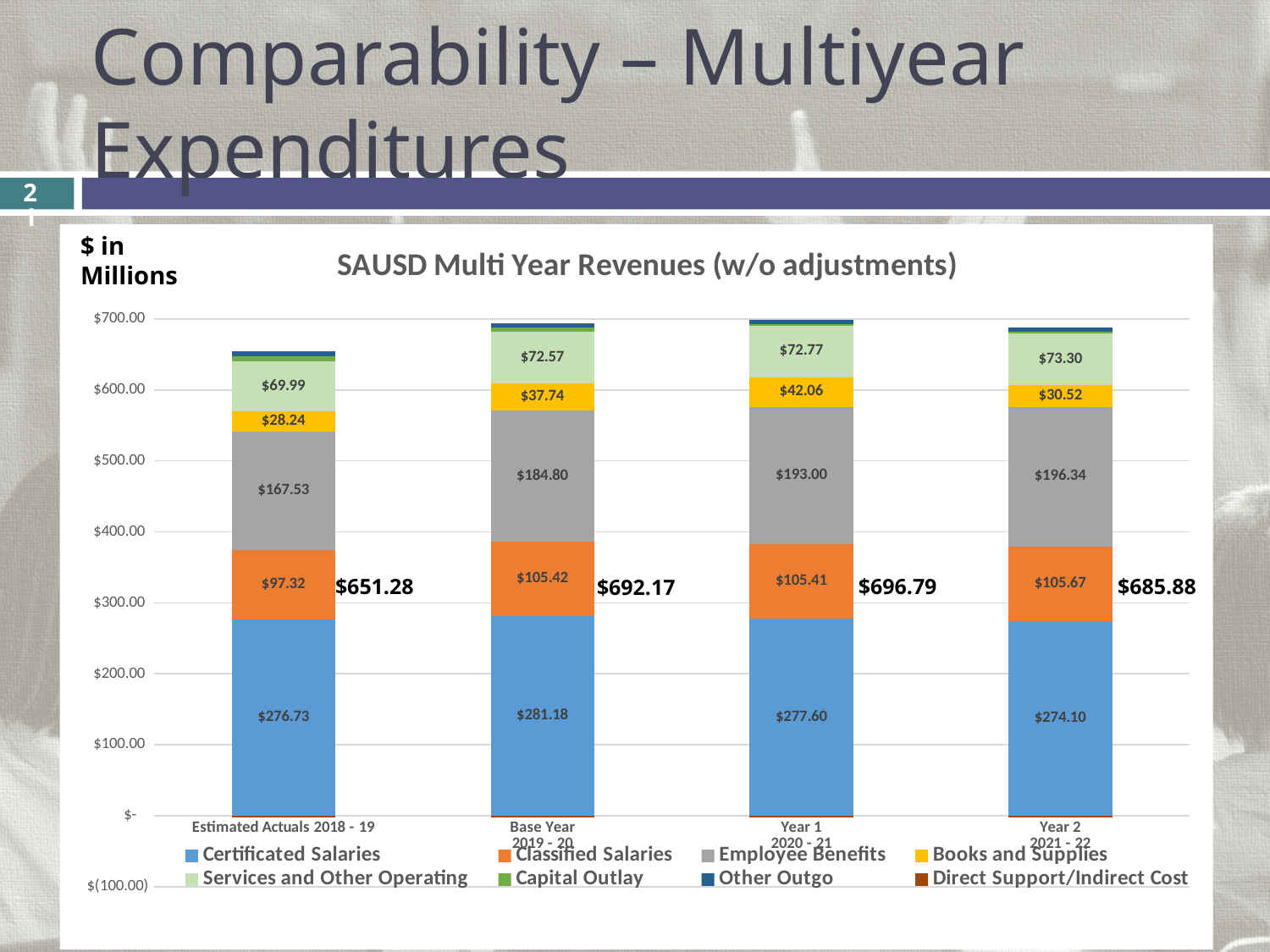
What is the Employee Benefits value for Year 2 2021 - 22? $196.34 What is the title of the chart? SAUSD Multi Year Revenues (w/o adjustments) What is the Certificated Salaries value for Base Year 2019 - 20? $281.18 What type of chart is shown on the slide? Stacked bar chart What is the Books and Supplies value for Year 1 2020 - 21? $42.06 Which year category has the highest total? Year 1 2020 - 21 How many series does the legend list? 8 What is the total shown for the Estimated Actuals 2018 - 19 bar? $651.28 How many bars (year categories) are plotted on the chart? 4 Which year category has the lowest Employee Benefits value? Estimated Actuals 2018 - 19 Is the Services and Other Operating value larger for Year 2 2021 - 22 or for Estimated Actuals 2018 - 19? Year 2 2021 - 22 What is the difference between the Employee Benefits values for Year 1 2020 - 21 and Base Year 2019 - 20? $8.20